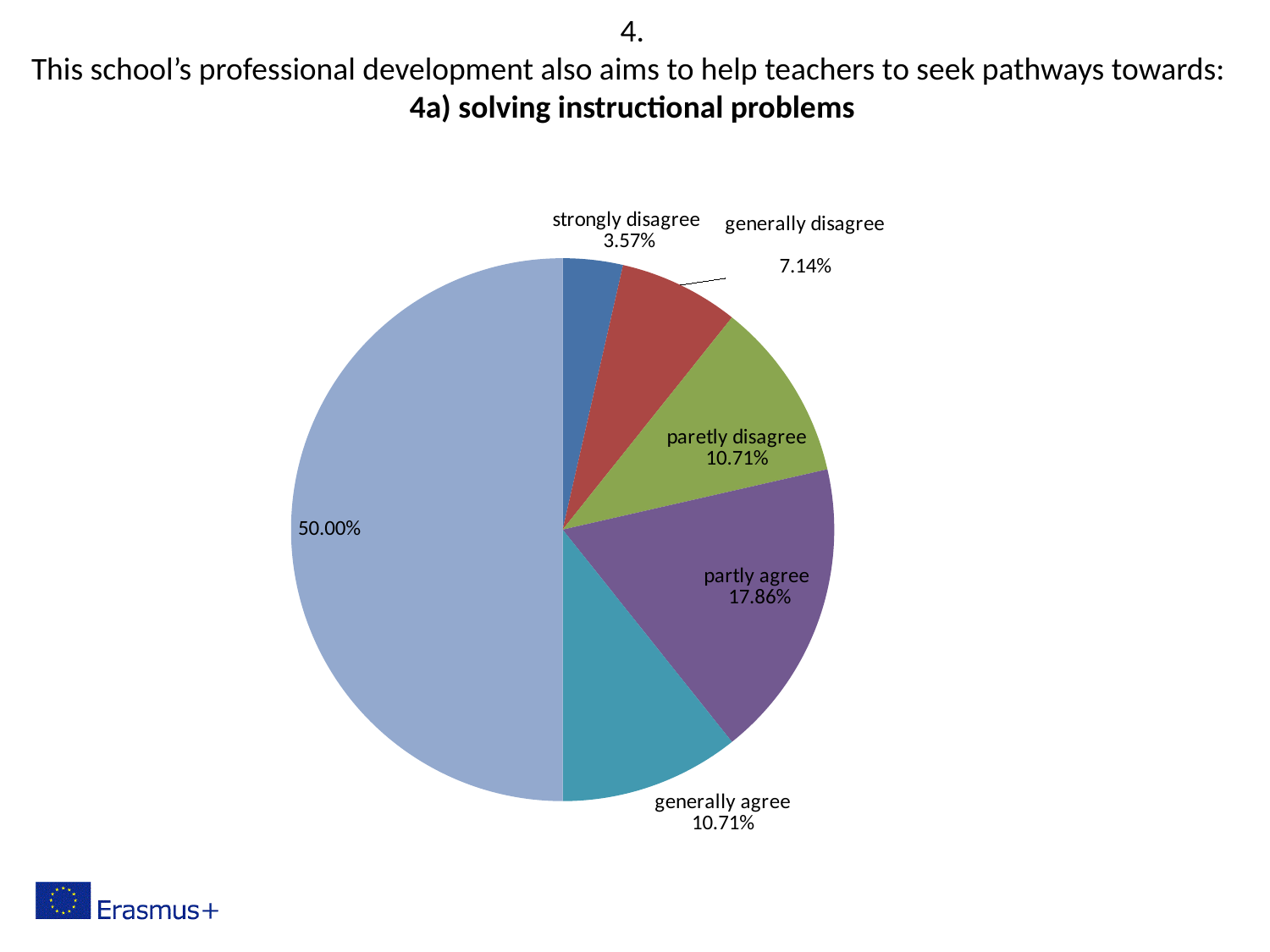
What percentage of respondents chose "generally disagree"? 7.14% What percentage of respondents chose "strongly disagree"? 3.57% Which slice is larger, "partly agree" or "generally agree"? partly agree What is the title of the chart's sub-item shown in bold on the slide? 4a) solving instructional problems How many slices does the pie chart have? 6 What is the combined percentage of "strongly disagree" and "generally disagree"? 10.71% What percentage is shown on the largest slice of the pie? 50.00% What percentage of respondents chose "generally agree"? 10.71% What kind of chart is shown on the slide? pie chart What is the difference between the "partly agree" and "generally disagree" percentages? 10.72% What percentage of respondents chose "partly agree"? 17.86% Which labelled response has the smallest slice of the pie? strongly disagree